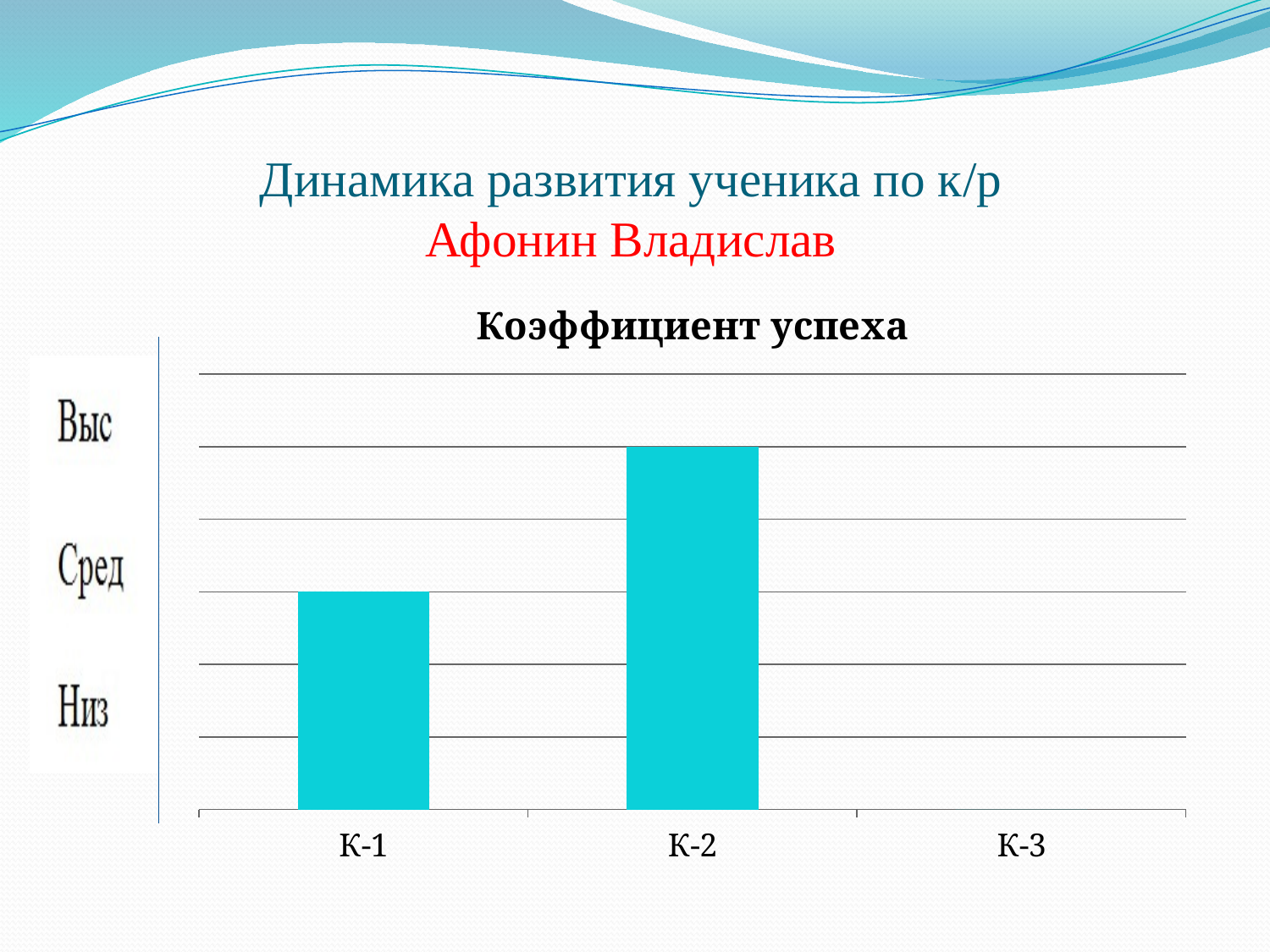
What is the title of the chart? Коэффициент успеха Which level label (Выс, Сред or Низ) does the bar for К-2 reach? Выс Which level label (Выс, Сред or Низ) does the bar for К-1 reach? Сред Which category has the highest bar in the chart? К-2 Which of К-1 and К-2 has the larger value? К-2 Does the value rise or fall from К-1 to К-2? rise What kind of chart is shown on the slide? bar chart What are the category labels on the x axis of the chart? К-1, К-2, К-3 Which category on the x axis has no bar plotted? К-3 How many categories are shown on the x axis of the chart? 3